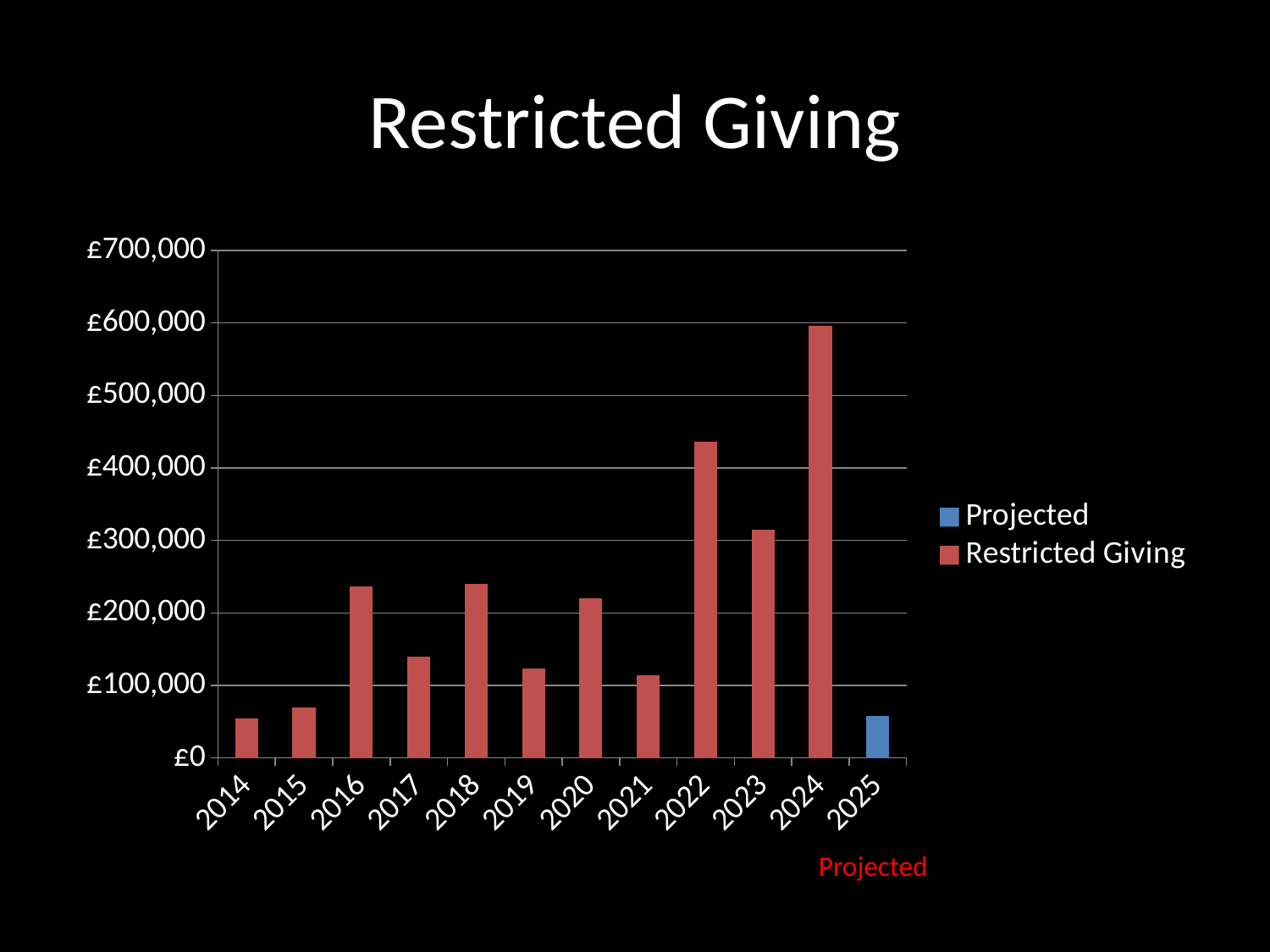
Which year has the highest restricted giving? 2024 What colour is the bar for the Projected series? blue What is the title of the chart? Restricted Giving Is the value for 2022 greater or less than £400,000? greater What kind of chart is shown on the slide? bar chart How many years are shown on the x axis? 12 Is the value for 2016 greater or less than £200,000? greater Which year has the larger value, 2022 or 2023? 2022 How many series does the legend list? 2 Is the value for 2024 greater or less than £500,000? greater Which year has the larger value, 2018 or 2017? 2018